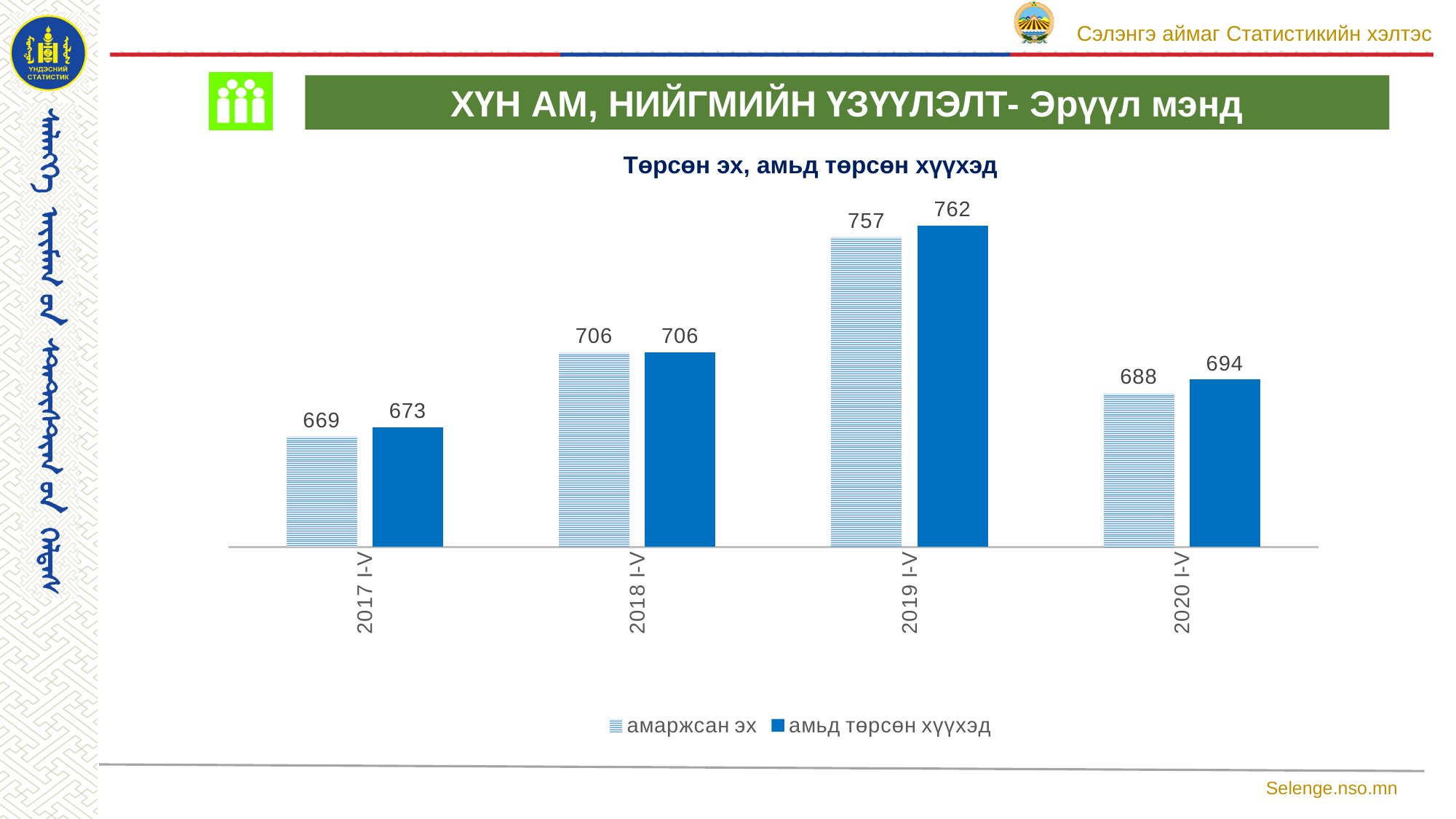
What is the value for амьд төрсөн хүүхэд in 2019 I-V? 762 What is the value for амаржсан эх in 2017 I-V? 669 Which period has the highest value for амаржсан эх? 2019 I-V What is the difference between the амаржсан эх values for 2019 I-V and 2018 I-V? 51 What is the difference between амьд төрсөн хүүхэд and амаржсан эх in 2020 I-V? 6 What is the title of the chart? Төрсөн эх, амьд төрсөн хүүхэд How many series does the legend list? 2 How many periods are shown on the x axis? 4 What kind of chart is shown? bar chart Which period has the lowest value for амьд төрсөн хүүхэд? 2017 I-V What is the value for амьд төрсөн хүүхэд in 2020 I-V? 694 Which is larger: амаржсан эх in 2018 I-V or амаржсан эх in 2020 I-V? 2018 I-V